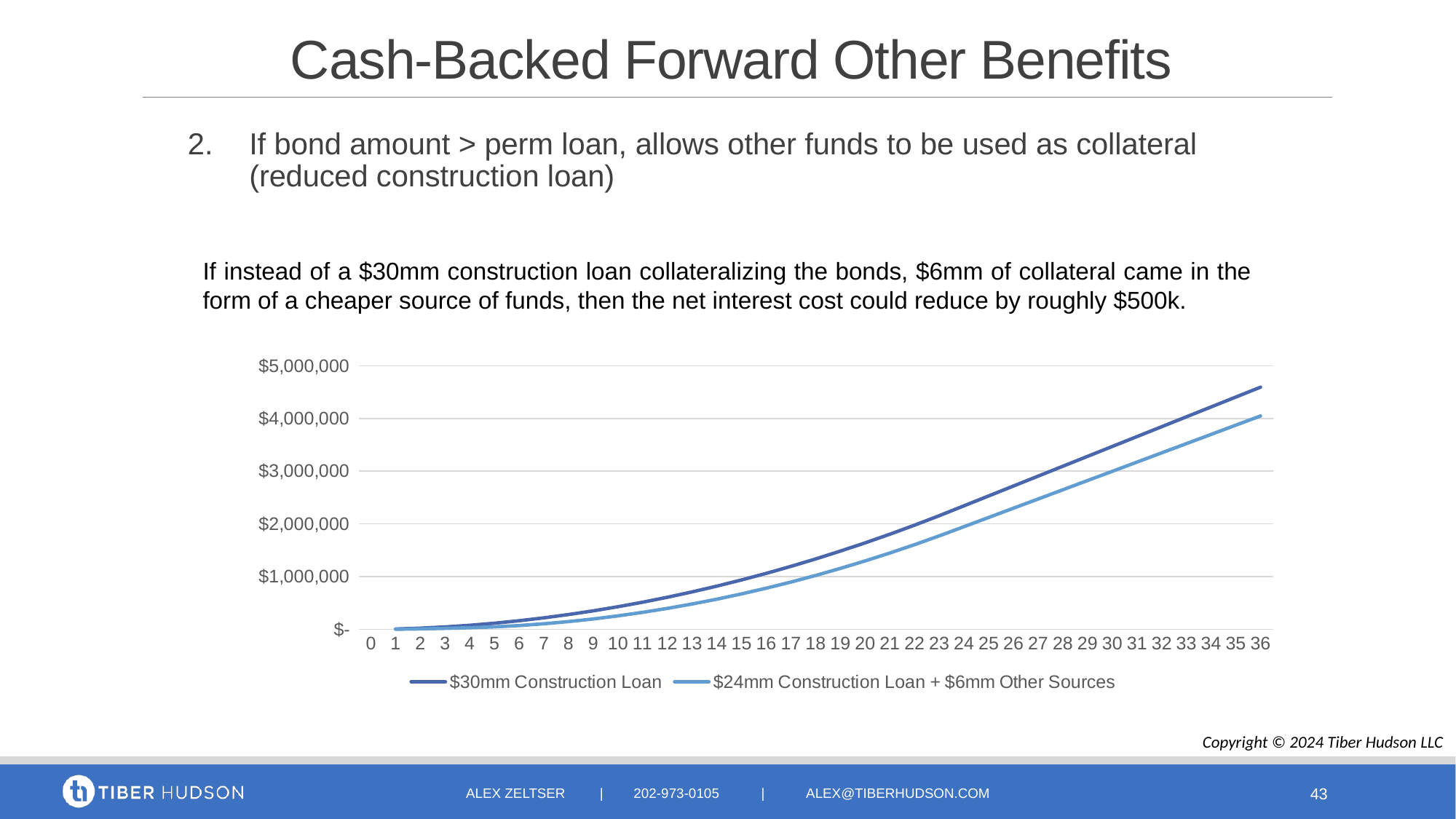
What kind of chart is shown on the slide? line chart Is the value of the $24mm Construction Loan + $6mm Other Sources series at x = 36 greater or less than $5,000,000? less Do the values of the $24mm Construction Loan + $6mm Other Sources series rise or fall along the x axis? rise Is the value of the $30mm Construction Loan series at x = 36 greater or less than $4,000,000? greater Do the values of the $30mm Construction Loan series rise or fall as the x axis goes from 0 to 36? rise How many points are labelled along the chart's x axis (from 0 to 36)? 37 What is the highest value shown on the chart's vertical axis? $5,000,000 How many series does the chart's legend list? 2 Is the value of the $30mm Construction Loan series at x = 12 greater or less than $1,000,000? less At x = 36, which series has the larger value: $30mm Construction Loan or $24mm Construction Loan + $6mm Other Sources? $30mm Construction Loan What are the two series named in the chart legend? $30mm Construction Loan; $24mm Construction Loan + $6mm Other Sources